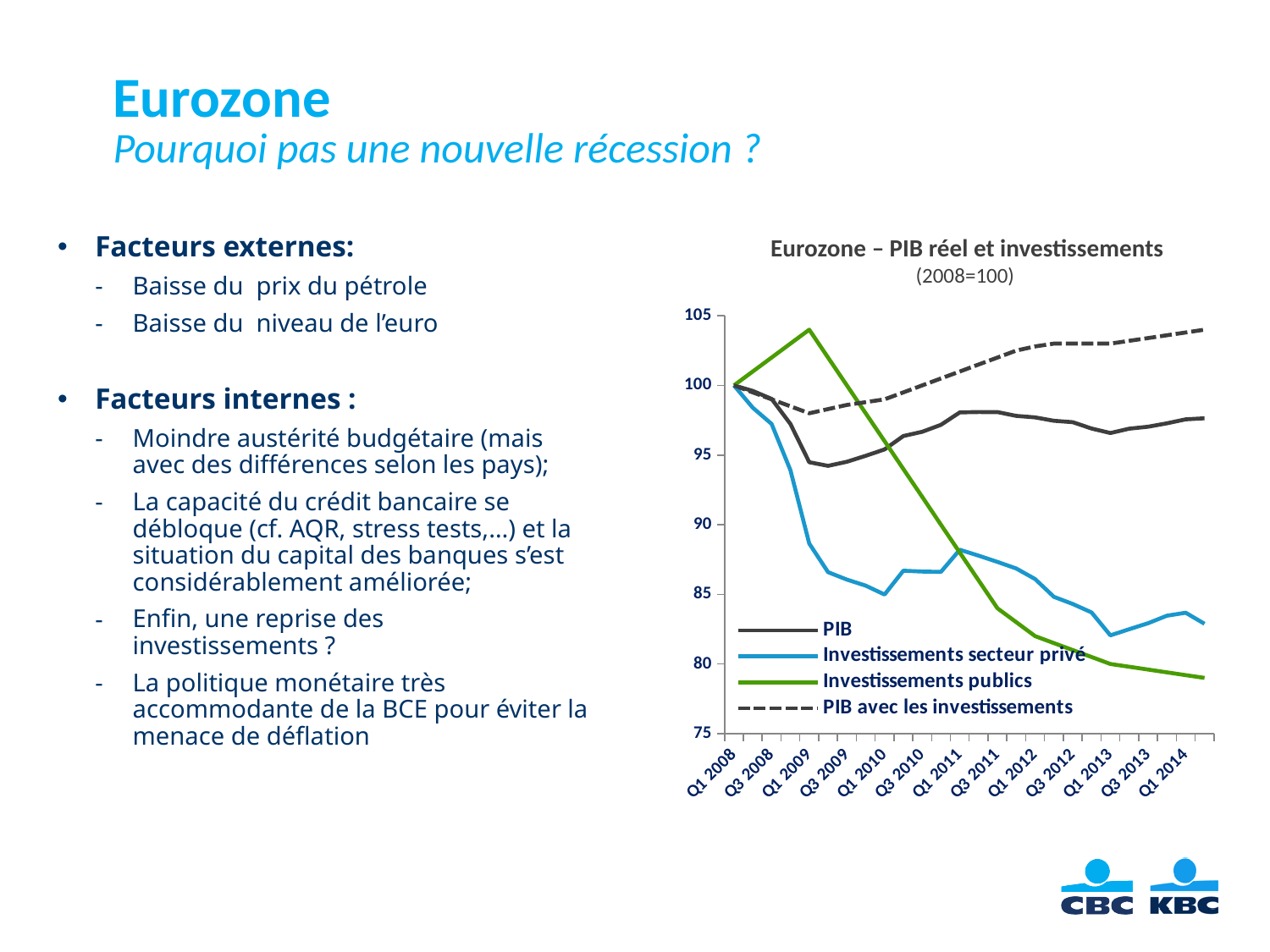
Which series has the highest value at Q1 2014? PIB avec les investissements Is the value for Investissements publics at Q1 2014 greater or less than 80? less How many series does the chart legend list? 4 Do the values for Investissements publics rise or fall from Q1 2009 to Q1 2014? fall Do the values for PIB avec les investissements rise or fall from Q1 2010 to Q1 2014? rise Is the value for Investissements publics at Q1 2009 greater or less than 100? greater Which series has the lowest value at Q1 2014? Investissements publics What kind of chart is shown on the slide? line chart Which series is drawn with a dashed line? PIB avec les investissements What is the title of the chart? Eurozone – PIB réel et investissements Is the value for PIB at Q1 2014 greater or less than 95? greater